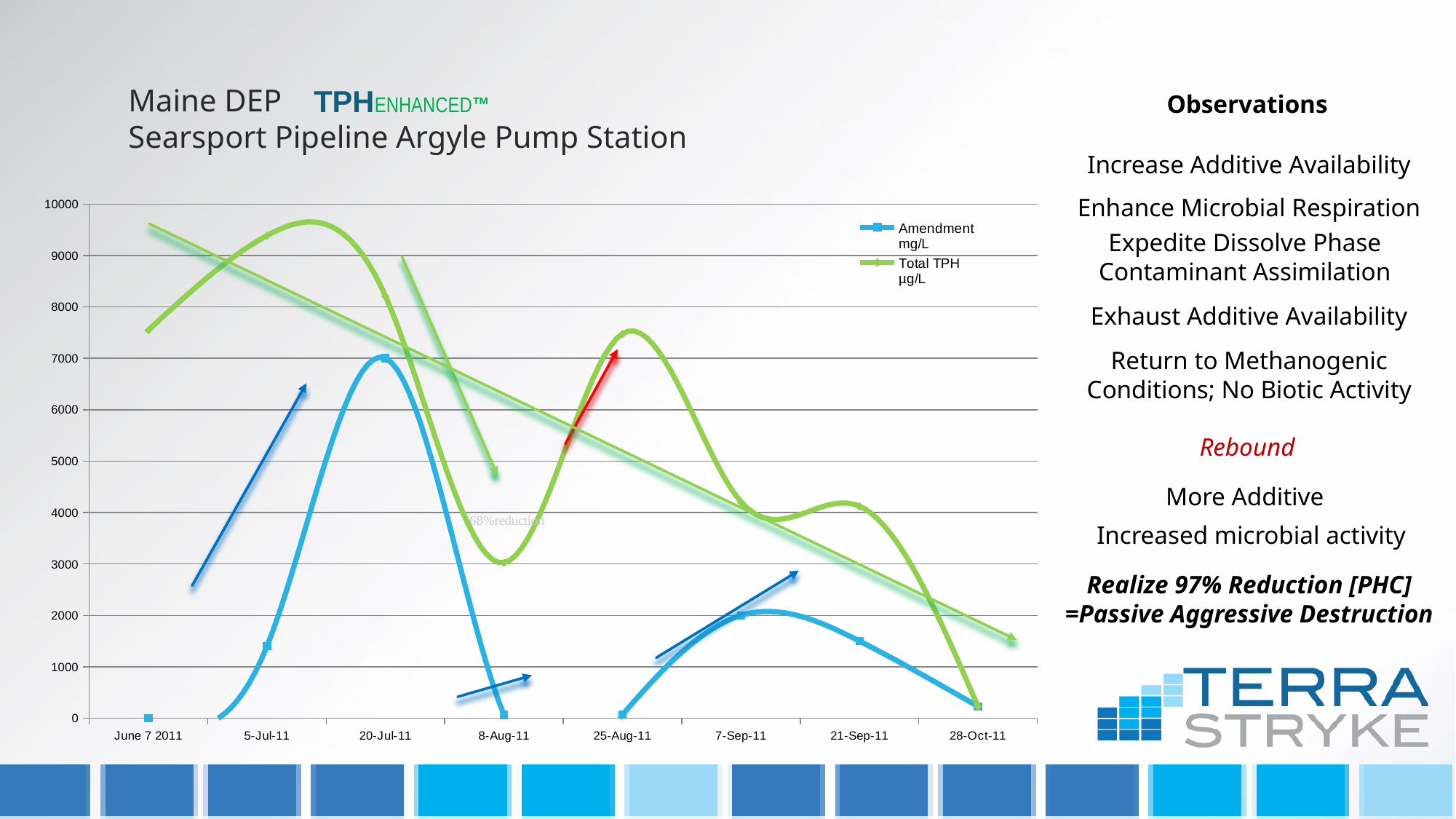
How many dates are shown along the x axis of the chart? 8 Is the Total TPH µg/L value on 5-Jul-11 greater or less than 9000? greater On which date is Total TPH µg/L highest? 5-Jul-11 Is the Amendment mg/L value on 21-Sep-11 greater or less than 1000? greater What is the Amendment mg/L value on June 7 2011? 0 On which date is Amendment mg/L highest? 20-Jul-11 Does Total TPH µg/L overall rise or fall from June 7 2011 to 28-Oct-11? fall How many series does the chart legend list? 2 What kind of chart is shown on the slide? line chart Which series is drawn in green on the chart? Total TPH µg/L On which date is Total TPH µg/L lowest? 28-Oct-11 Which is larger: Amendment mg/L on 20-Jul-11 or on 7-Sep-11? 20-Jul-11